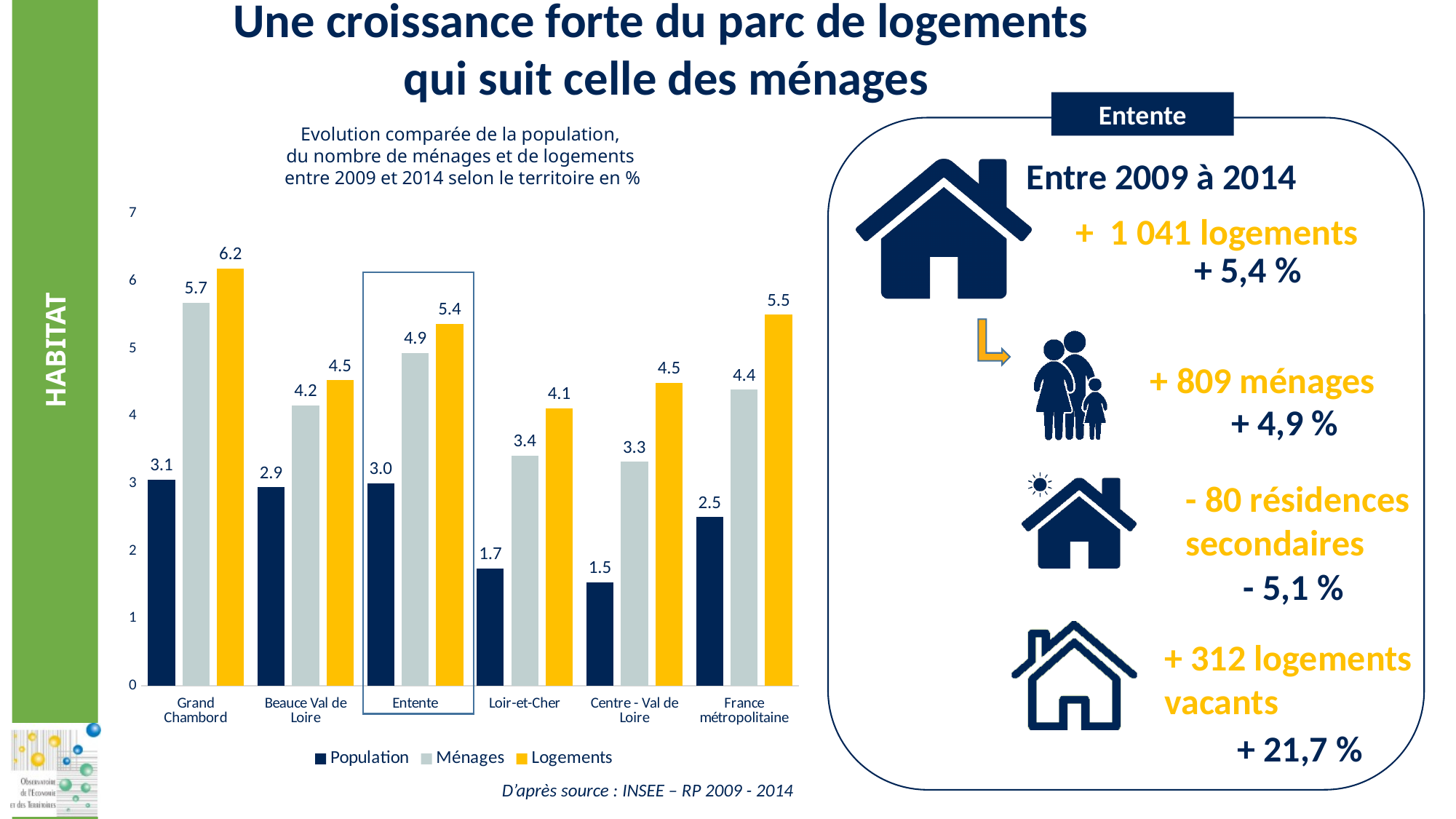
Which series is shown in yellow in the chart? Logements How many territories are shown on the x axis of the chart? 6 What kind of chart is shown on the slide? Bar chart What is the difference between the Logements and Population values for Entente? 2.4 What is the Logements value for Grand Chambord? 6.2 Which territory has the highest Logements value? Grand Chambord What is the Population value for Loir-et-Cher? 1.7 Which territory has the lowest Population value? Centre - Val de Loire What is the Logements value for France métropolitaine? 5.5 How many series does the chart legend list? 3 Which is larger, the Ménages value for Beauce Val de Loire or the Ménages value for France métropolitaine? France métropolitaine What is the Ménages value for Entente? 4.9